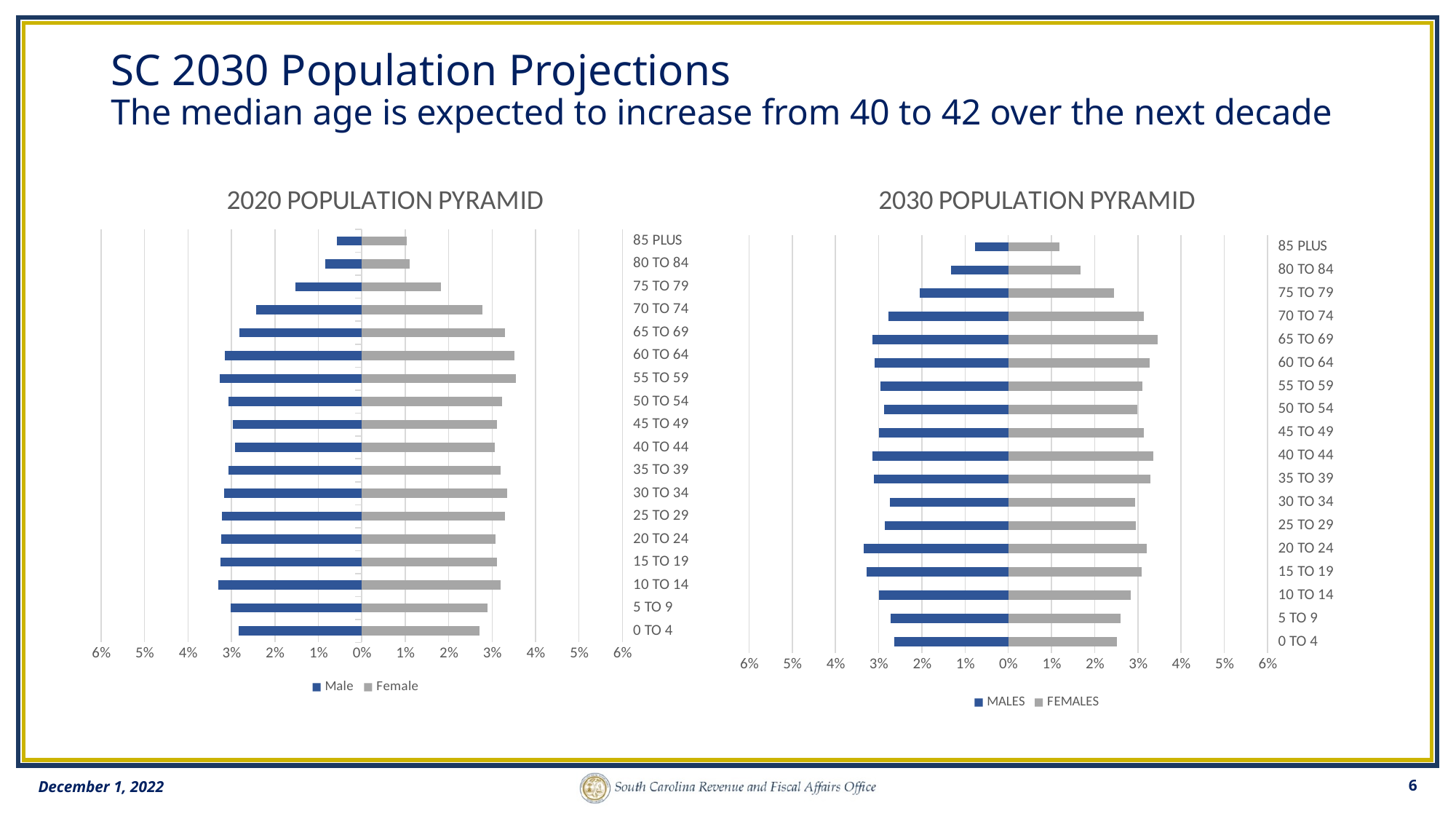
In the 2020 Population Pyramid, is the Male value for 75 TO 79 greater or less than 2%? less In the 2020 Population Pyramid, which is larger for 85 PLUS, the Male value or the Female value? Female In the 2020 Population Pyramid, is the Female value for 60 TO 64 greater or less than 3%? greater How many age groups are shown in the 2030 Population Pyramid? 18 What type of chart is the 2020 Population Pyramid? bar chart What are the legend entries of the 2030 Population Pyramid? MALES, FEMALES How many series does the legend of the 2020 Population Pyramid list? 2 In the 2020 Population Pyramid, which age group has the smallest Male value? 85 PLUS In the 2030 Population Pyramid, is the MALES value for 20 TO 24 greater or less than 3%? greater In the 2030 Population Pyramid, which age group has the largest MALES value? 20 TO 24 What is the title of the chart on the left side of the slide? 2020 POPULATION PYRAMID